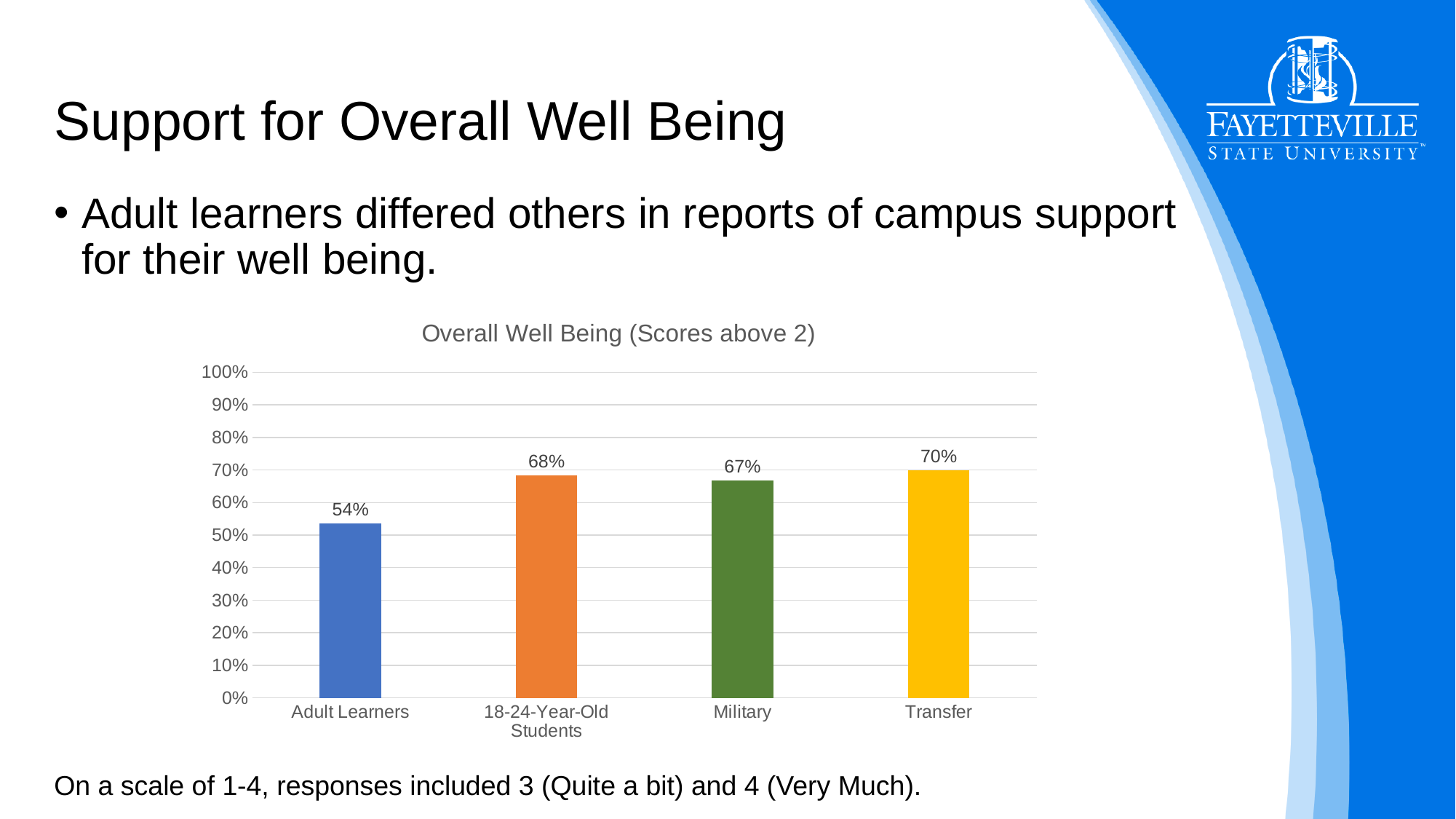
Which category has the highest value? Transfer Which is larger, the value for Adult Learners or the value for Military? Military Which category has the lowest value? Adult Learners Is the value for Adult Learners greater or less than 60%? less What is the difference between the values for 18-24-Year-Old Students and Military? 1% How many categories are shown in the chart? 4 What is the value for 18-24-Year-Old Students? 68% What is the difference between the values for Transfer and Adult Learners? 16% What is the value for Transfer? 70% What is the value for Military? 67% What is the title of the chart? Overall Well Being (Scores above 2) What is the value for Adult Learners? 54%